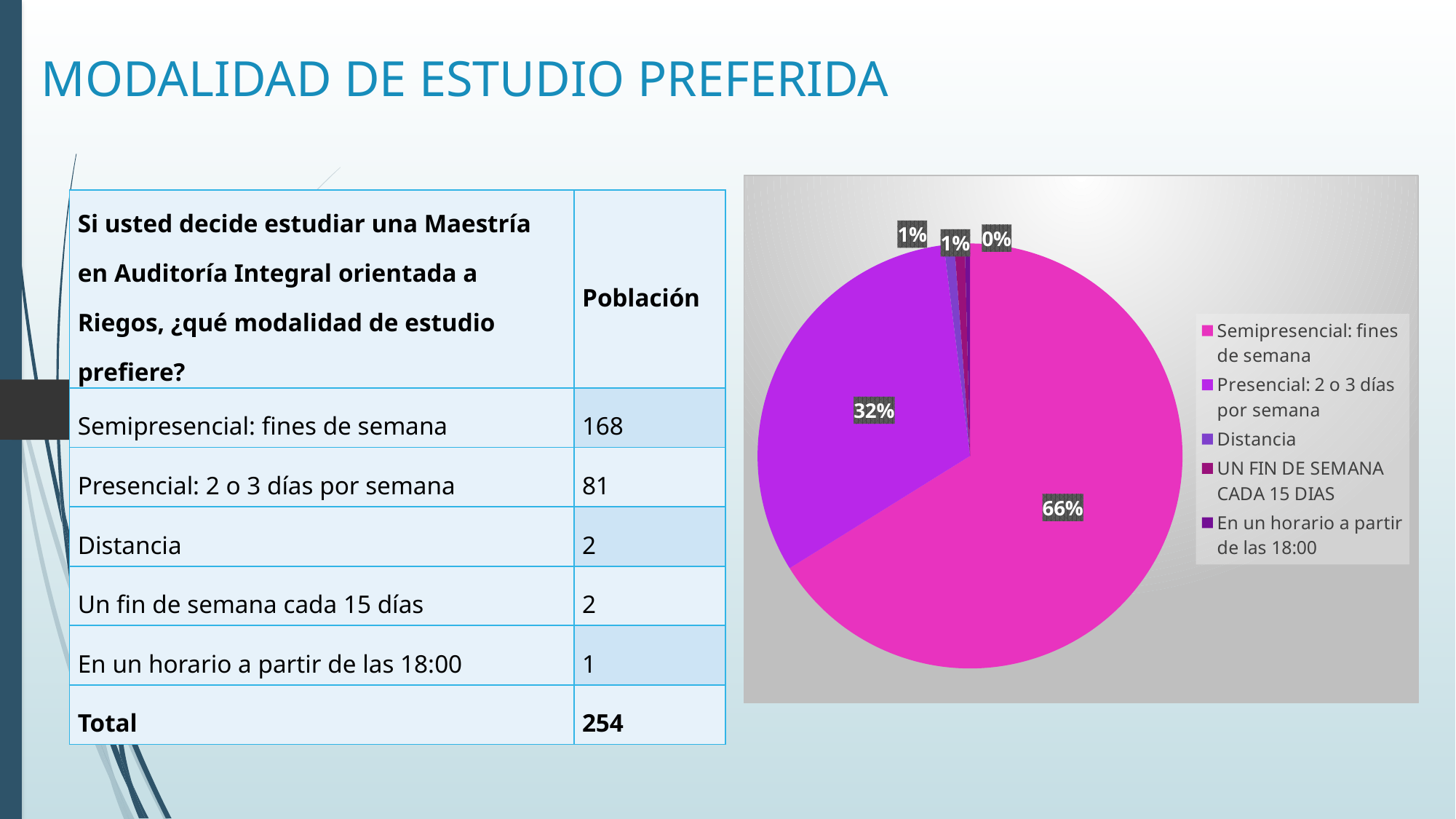
What share of the pie does 'Presencial: 2 o 3 días por semana' have? 32% What share of the pie does 'En un horario a partir de las 18:00' have? 0% How many categories does the pie chart's legend list? 5 Which slice is larger: 'Semipresencial: fines de semana' or 'Presencial: 2 o 3 días por semana'? Semipresencial: fines de semana What kind of chart is shown on the slide? pie chart What is the difference in percentage points between the 'Semipresencial: fines de semana' slice and the 'Presencial: 2 o 3 días por semana' slice? 34 Which category has the smallest slice of the pie? En un horario a partir de las 18:00 What share of the pie does 'Semipresencial: fines de semana' have? 66% Which category has the largest slice of the pie? Semipresencial: fines de semana What colour is the largest slice of the pie chart? magenta (pink) What is the third entry in the pie chart's legend? Distancia